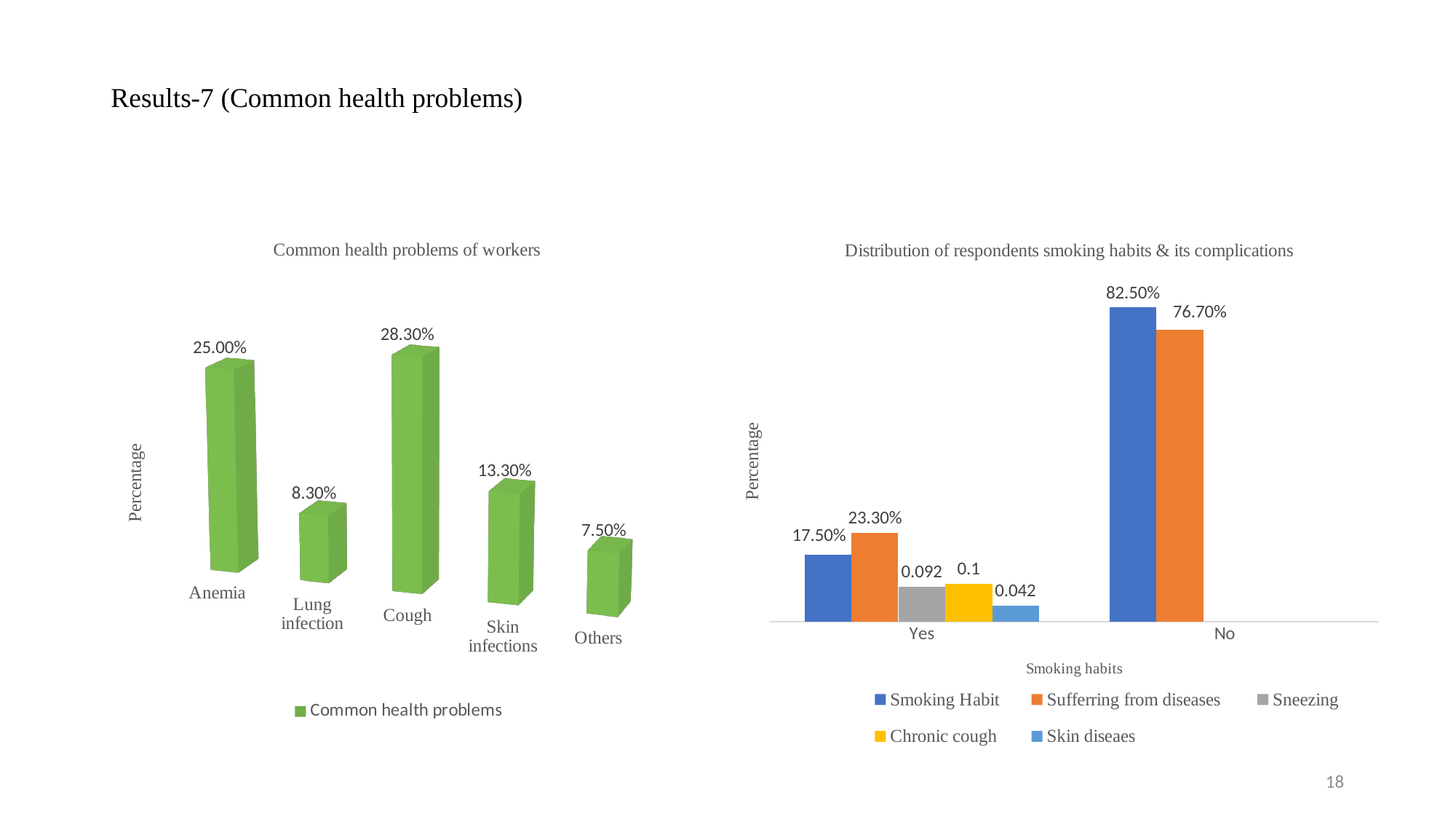
In the 'Common health problems of workers' chart, how many categories are shown? 5 What kind of chart is the 'Distribution of respondents smoking habits & its complications' chart? Bar chart In the 'Common health problems of workers' chart, which is larger: Skin infections or Lung infection? Skin infections In the 'Distribution of respondents smoking habits & its complications' chart, what is the value for Smoking Habit in the No category? 82.50% In the 'Distribution of respondents smoking habits & its complications' chart, what is the value for Chronic cough in the Yes category? 0.1 In the 'Distribution of respondents smoking habits & its complications' chart, how many series does the legend list? 5 In the 'Common health problems of workers' chart, what is the difference between the values for Cough and Anemia? 3.30% In the 'Common health problems of workers' chart, what is the value for Cough? 28.30% In the 'Common health problems of workers' chart, which category has the lowest value? Others In the 'Common health problems of workers' chart, what is the value for Lung infection? 8.30% In the 'Distribution of respondents smoking habits & its complications' chart, what is the value for Sufferring from diseases in the Yes category? 23.30% In the 'Common health problems of workers' chart, which category has the highest value? Cough